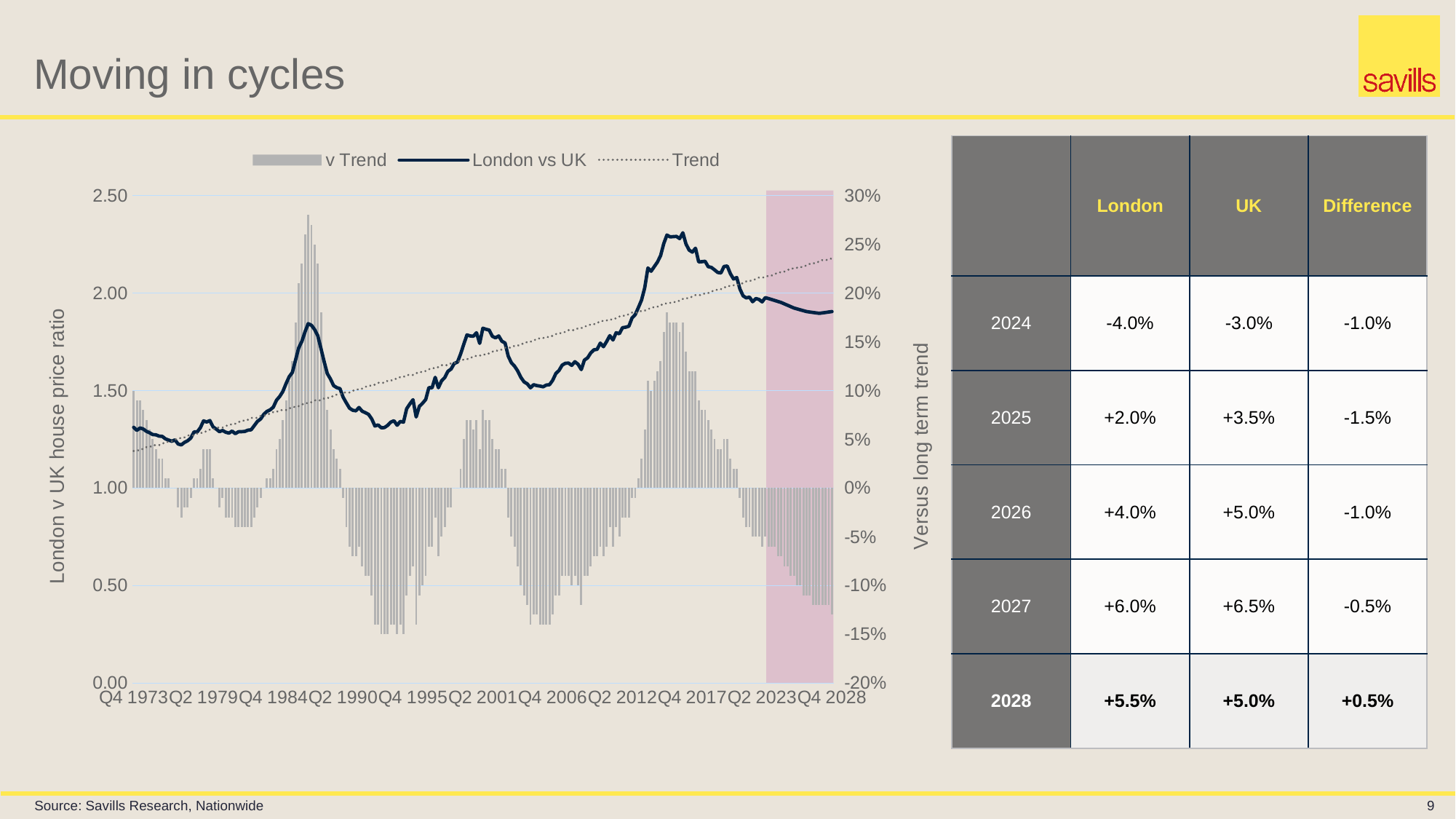
What kind of chart is shown on the slide? Combined bar and line chart Which is higher on the chart: the London vs UK ratio peak around 2017Q2 or the peak around 2001Q4? The peak around 2017Q2 What is the highest value shown on the right-hand axis of the chart? 30% What is the title of the left vertical axis of the chart? London v UK house price ratio How many series does the chart legend list? 3 Is the London vs UK ratio at its peak around 2017Q2 greater or less than 2.00? greater What are the three series named in the chart legend? v Trend, London vs UK, Trend Is the London vs UK ratio at its peak around 1984Q2 greater or less than 1.50? greater Does the dotted Trend line rise or fall along the x axis? Rise Is the v Trend bar at its lowest point around 1990Q4 greater or less than -10%? less